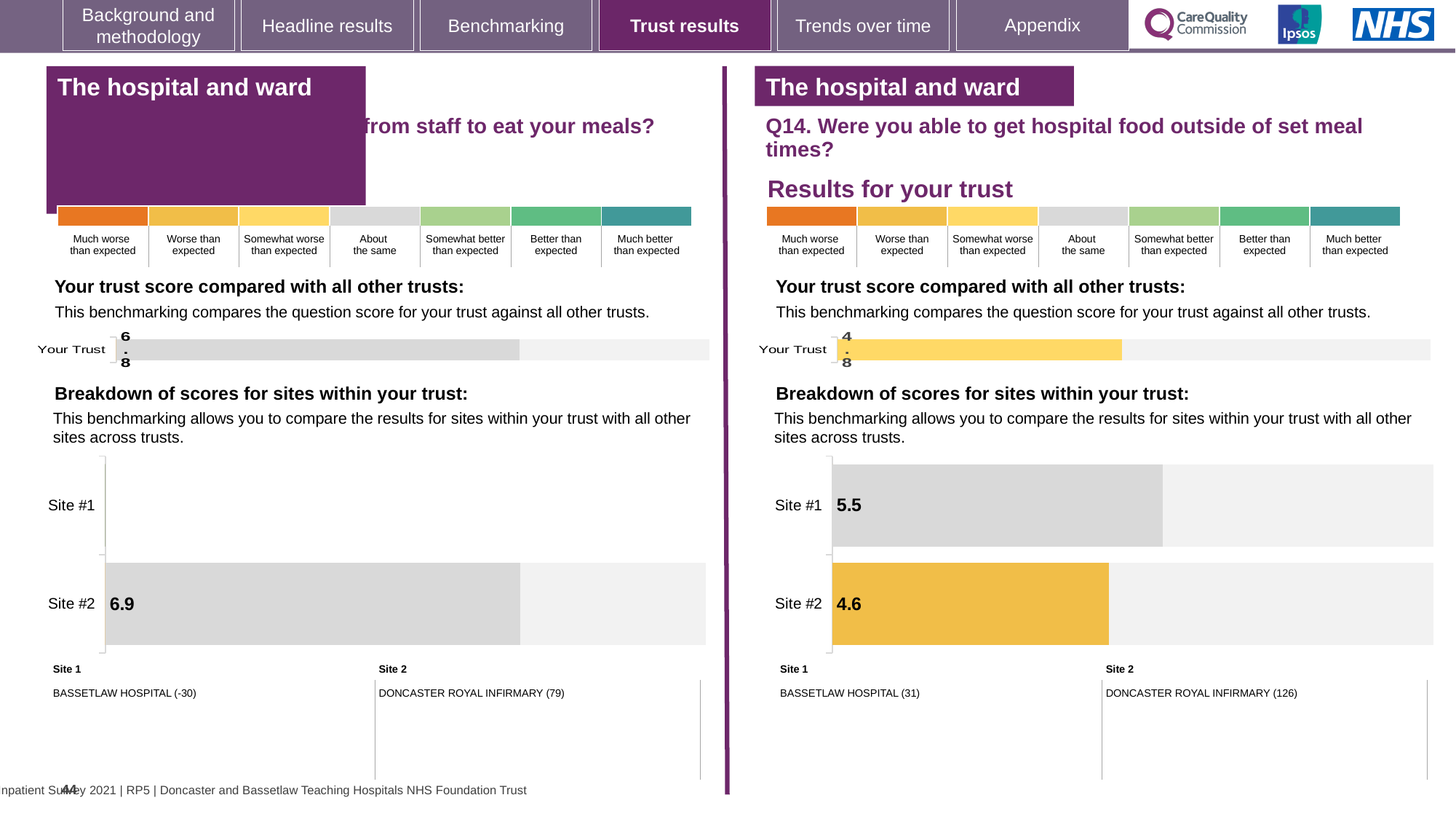
On the left-hand site breakdown chart, what is the score for Site #2? 6.9 On the Q14 site breakdown chart, what is the score for Site #2? 4.6 What type of chart is the Q14 site breakdown chart? Bar chart On the Q14 site breakdown chart, which site has the higher score? Site #1 On the left-hand 'Your trust score compared with all other trusts' chart, what is the score for Your Trust? 6.8 On the Q14 'Your trust score compared with all other trusts' chart, what is the score for Your Trust? 4.8 On the Q14 site breakdown chart, how many sites are shown? 2 On the Q14 site breakdown chart, what is the score for Site #1? 5.5 On the Q14 site breakdown chart, what colour is the bar for Site #2? Yellow On the Q14 site breakdown chart, what colour is the bar for Site #1? Grey Which is higher: the Your Trust score on the left-hand trust chart or the Your Trust score on the Q14 trust chart? The left-hand trust chart On the Q14 site breakdown chart, what is the difference between the Site #1 and Site #2 scores? 0.9